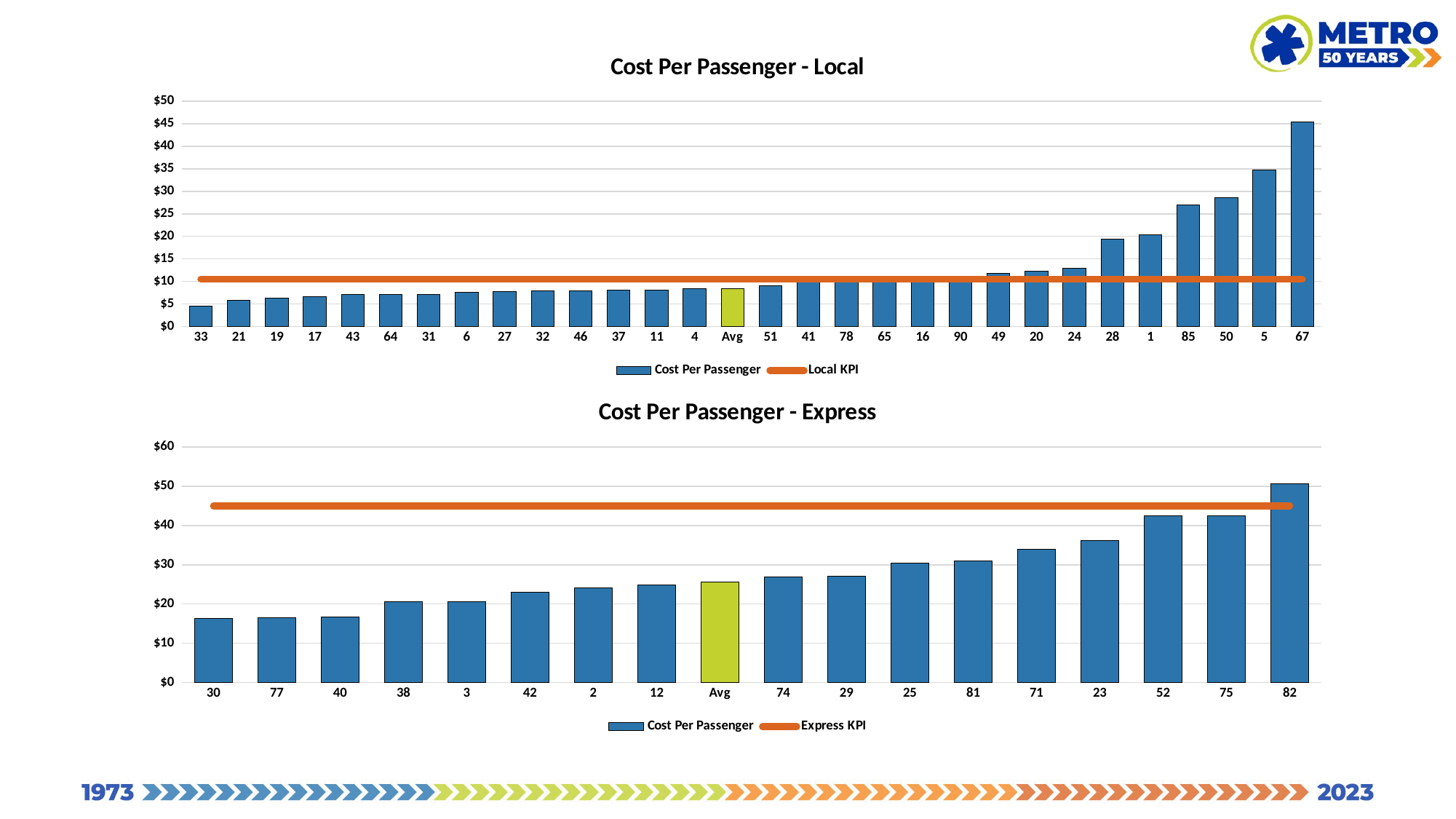
In the "Cost Per Passenger - Local" chart, is the value for 28 greater or less than $15? greater How many bars are plotted in the "Cost Per Passenger - Local" chart? 30 In the "Cost Per Passenger - Local" chart, is the value for 67 greater or less than $40? greater In the "Cost Per Passenger - Local" chart, which category has the lowest cost per passenger? 33 In the "Cost Per Passenger - Local" chart, which has a higher cost per passenger, 5 or 50? 5 How many bars are plotted in the "Cost Per Passenger - Express" chart? 18 What type of chart is "Cost Per Passenger - Local"? Combination bar and line chart In the "Cost Per Passenger - Express" chart, is the value for 23 greater or less than $40? less In the "Cost Per Passenger - Express" chart, which category has the highest cost per passenger? 82 In the "Cost Per Passenger - Express" chart, do the bar values rise or fall from left to right along the x axis? Rise In the "Cost Per Passenger - Local" chart, which category has the highest cost per passenger? 67